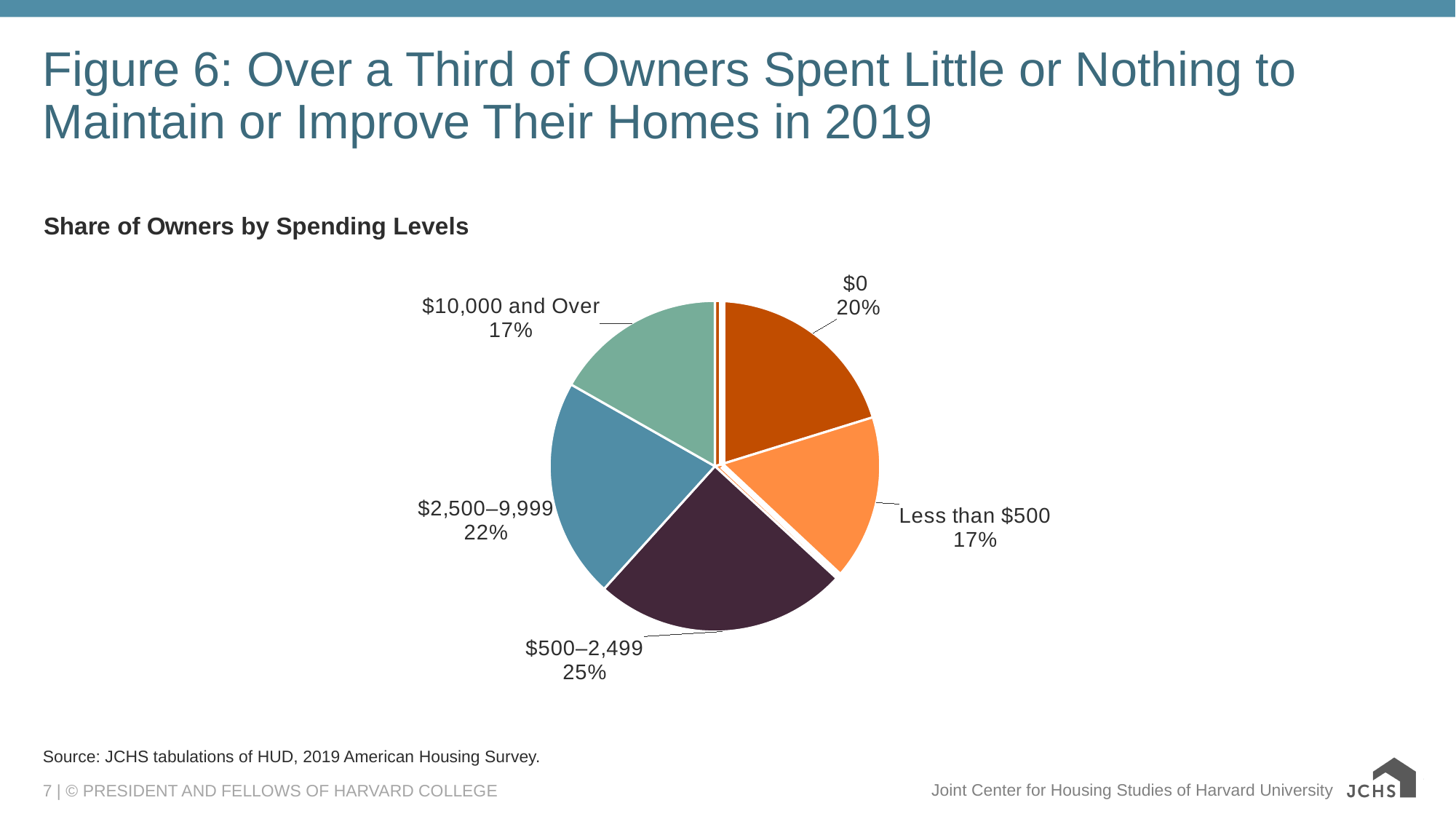
Which spending level has the largest share of owners? $500–2,499 What share of owners spent $10,000 and over? 17% What is the difference in percentage points between the share of owners who spent $500–2,499 and the share who spent $10,000 and over? 8 percentage points What share of owners spent $2,500–9,999? 22% Which is larger: the share of owners who spent $0 or the share who spent $2,500–9,999? $2,500–9,999 What share of owners spent $0 on maintaining or improving their homes? 20% What is the combined share of owners who spent $0 or less than $500? 37% What share of owners spent less than $500? 17% How many labeled spending-level slices does the pie chart have? 5 What is the title of the chart on the slide? Share of Owners by Spending Levels What kind of chart is shown on the slide? Pie chart What share of owners spent $500–2,499? 25%